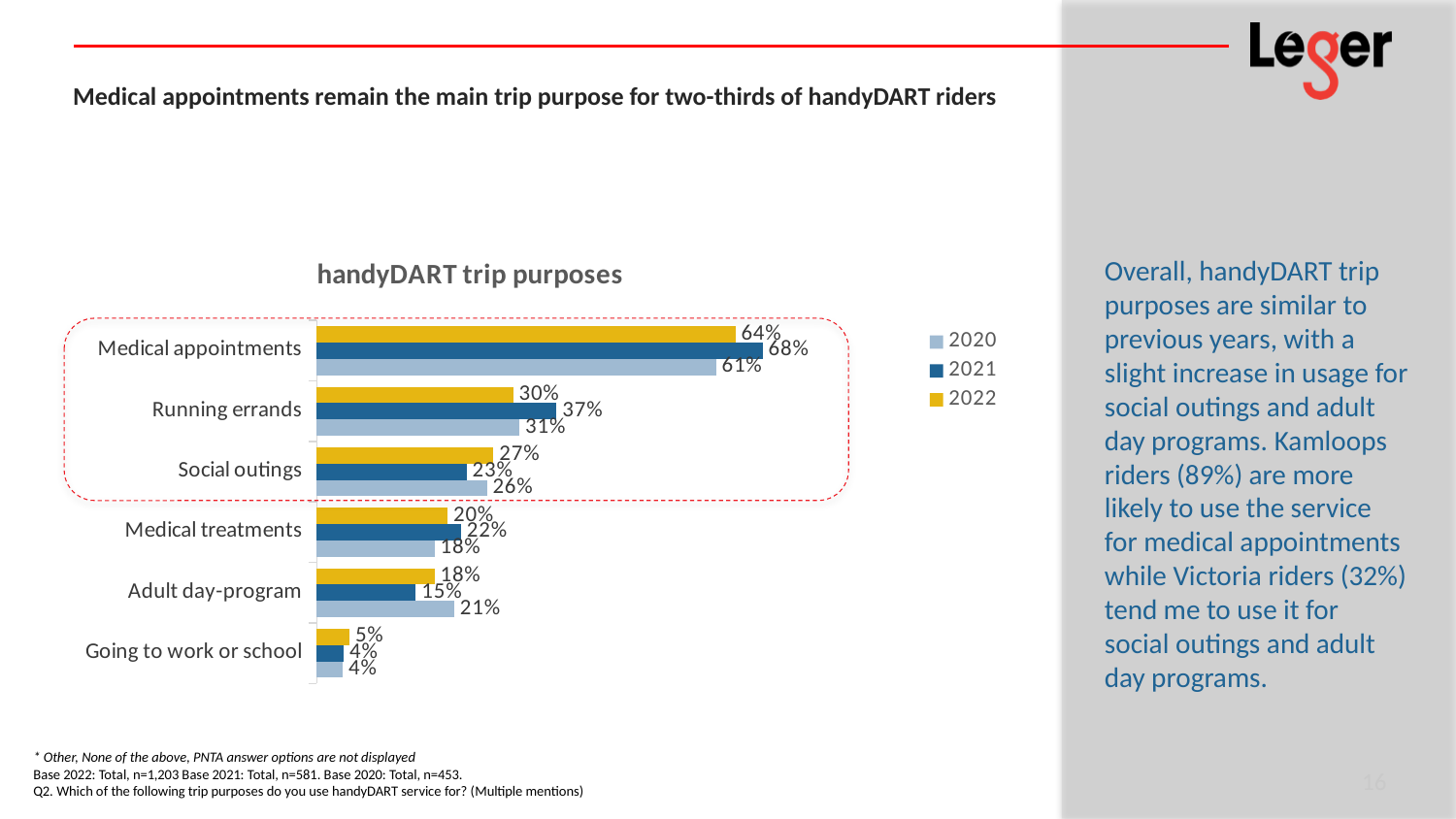
What kind of chart is shown on the slide? Bar chart What is the 2020 value for Adult day-program? 21% Which is larger for Adult day-program, the 2020 value or the 2021 value? 2020 How many series does the legend list? 3 Which trip purpose has the highest 2022 value? Medical appointments Which trip purpose has the lowest 2021 value? Going to work or school How many trip purpose categories are shown in the chart? 6 What is the title of the chart? handyDART trip purposes What is the 2021 value for Running errands? 37% What is the difference between the 2021 and 2020 values for Medical appointments? 7% What is the 2022 value for Medical appointments? 64% What is the 2022 value for Social outings? 27%